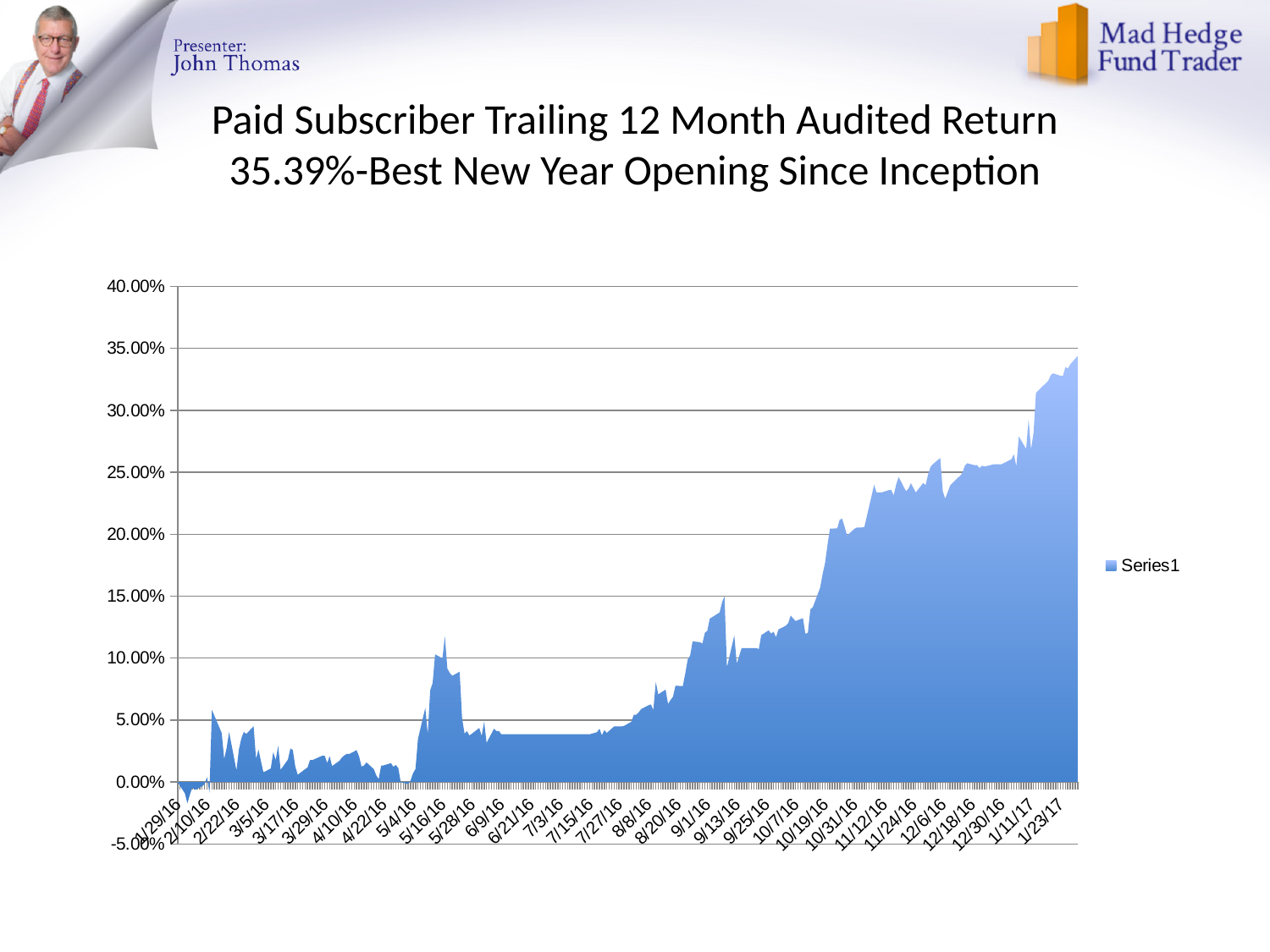
Is the value at 11/24/16 greater or less than 20.00%? greater Is the value at 4/10/16 greater or less than 5.00%? less Which is larger, the value at 1/23/17 or the value at 5/16/16? 1/23/17 Overall, do the values rise or fall from the start of the x axis to the end? Rise What is the title of the chart on the slide? Paid Subscriber Trailing 12 Month Audited Return 35.39%-Best New Year Opening Since Inception Is the value at 1/23/17 greater or less than 30.00%? greater What kind of chart is shown on the slide? Area chart What is the name of the series shown in the legend? Series1 How many series does the legend list? 1 What is the highest value shown on the y axis? 40.00%